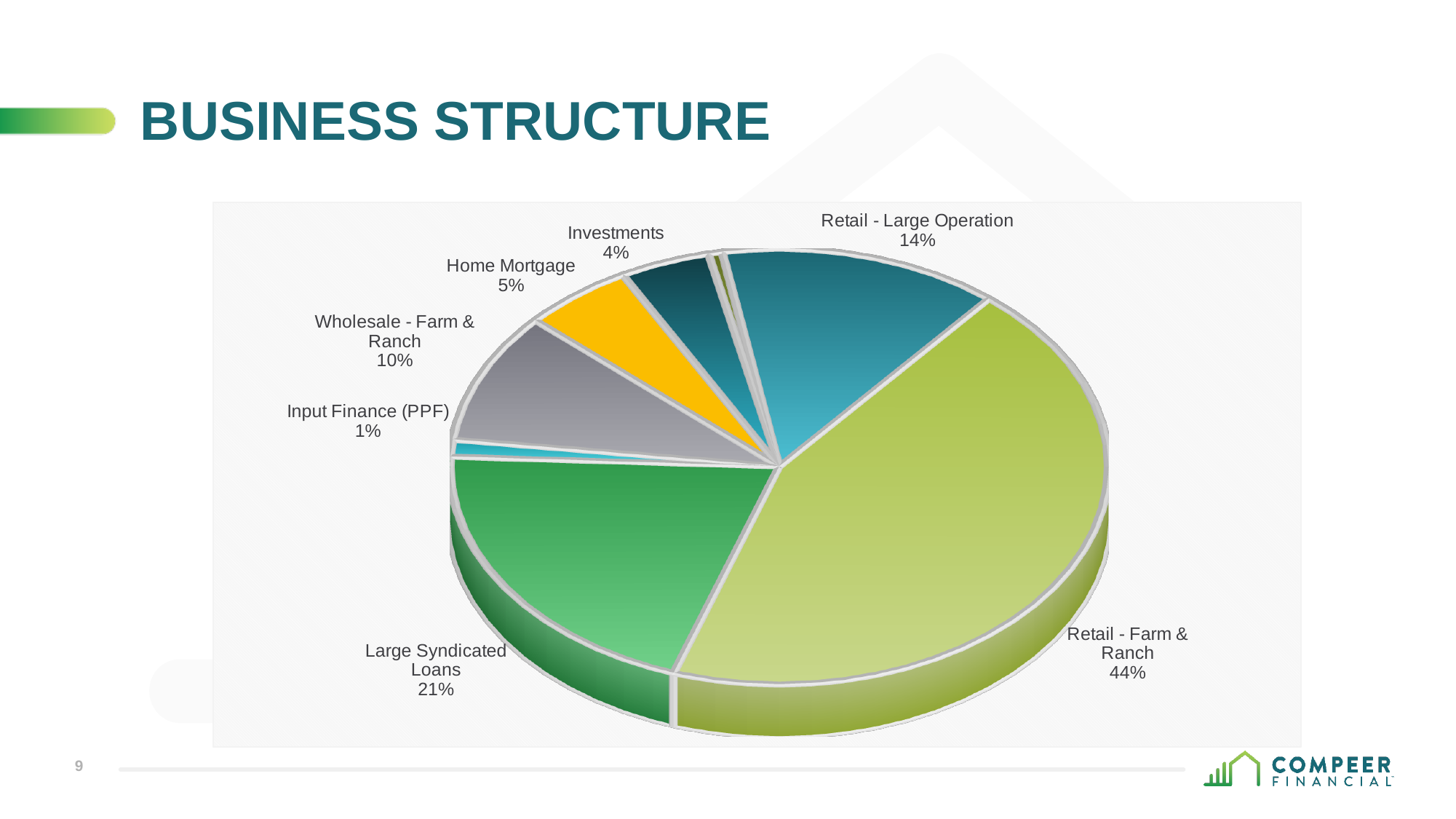
What is the title of the slide containing the chart? BUSINESS STRUCTURE Which is larger, Wholesale - Farm & Ranch or Home Mortgage? Wholesale - Farm & Ranch What is the difference in percentage points between Retail - Farm & Ranch and Large Syndicated Loans? 23 What percentage is shown for Large Syndicated Loans? 21% Which labeled category has the largest share of the pie? Retail - Farm & Ranch What kind of chart is shown on the slide? Pie chart Which labeled category has the smallest share of the pie? Input Finance (PPF) What percentage is shown for Home Mortgage? 5% What percentage is shown for Investments? 4% What percentage is shown for Retail - Large Operation? 14% What percentage is shown for Wholesale - Farm & Ranch? 10% What share of the pie does Retail - Farm & Ranch represent? 44%